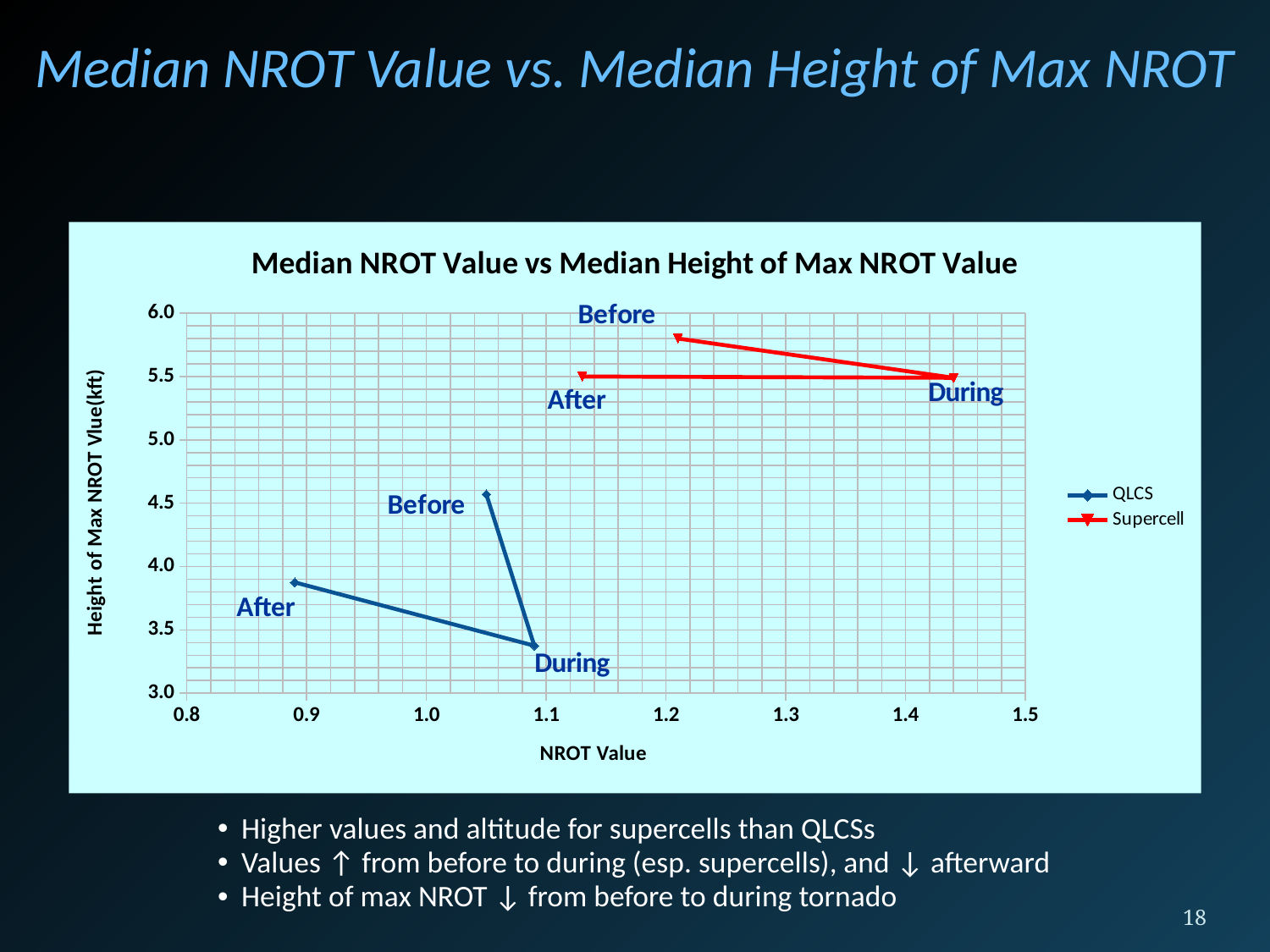
What is the title of the chart? Median NROT Value vs Median Height of Max NROT Value Which has a greater Height of Max NROT: the QLCS Before point or the QLCS During point? QLCS Before Which labeled point has the highest Height of Max NROT value? Supercell Before Is the Height of Max NROT for the QLCS During point greater or less than 3.5? less What are the two series named in the legend? QLCS and Supercell Is the Height of Max NROT for the Supercell Before point greater or less than 5.5? greater How many series does the legend list? 2 Which labeled point has the lowest NROT Value? QLCS After Which labeled point has the highest NROT Value? Supercell During Which labeled point has the lowest Height of Max NROT value? QLCS During What kind of chart is shown on the slide? scatter chart with connecting lines How many data points are plotted for the QLCS series? 3